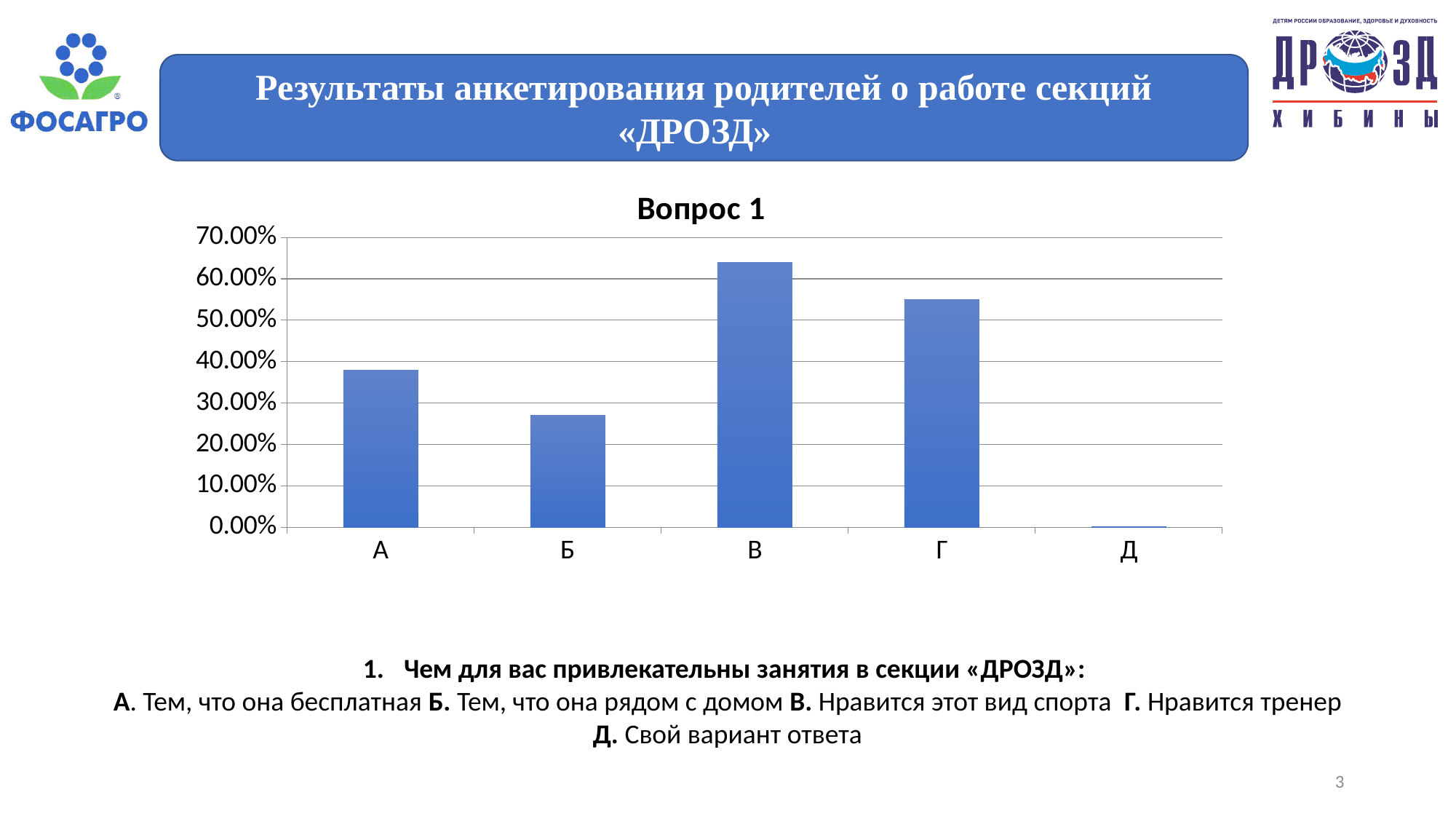
Which category has the highest bar in the chart? В Is the value for Г greater or less than 50.00%? greater Is the value for Б greater or less than 20.00%? greater What is the title of the chart? Вопрос 1 What is the highest value shown on the y axis of the chart? 70.00% Which is larger, the value for Г or the value for В? В Which is larger, the value for А or the value for Б? А Is the value for А greater or less than 40.00%? less How many categories are shown on the x axis of the chart? 5 What kind of chart is shown on the slide? bar chart Which category has the lowest bar in the chart? Д